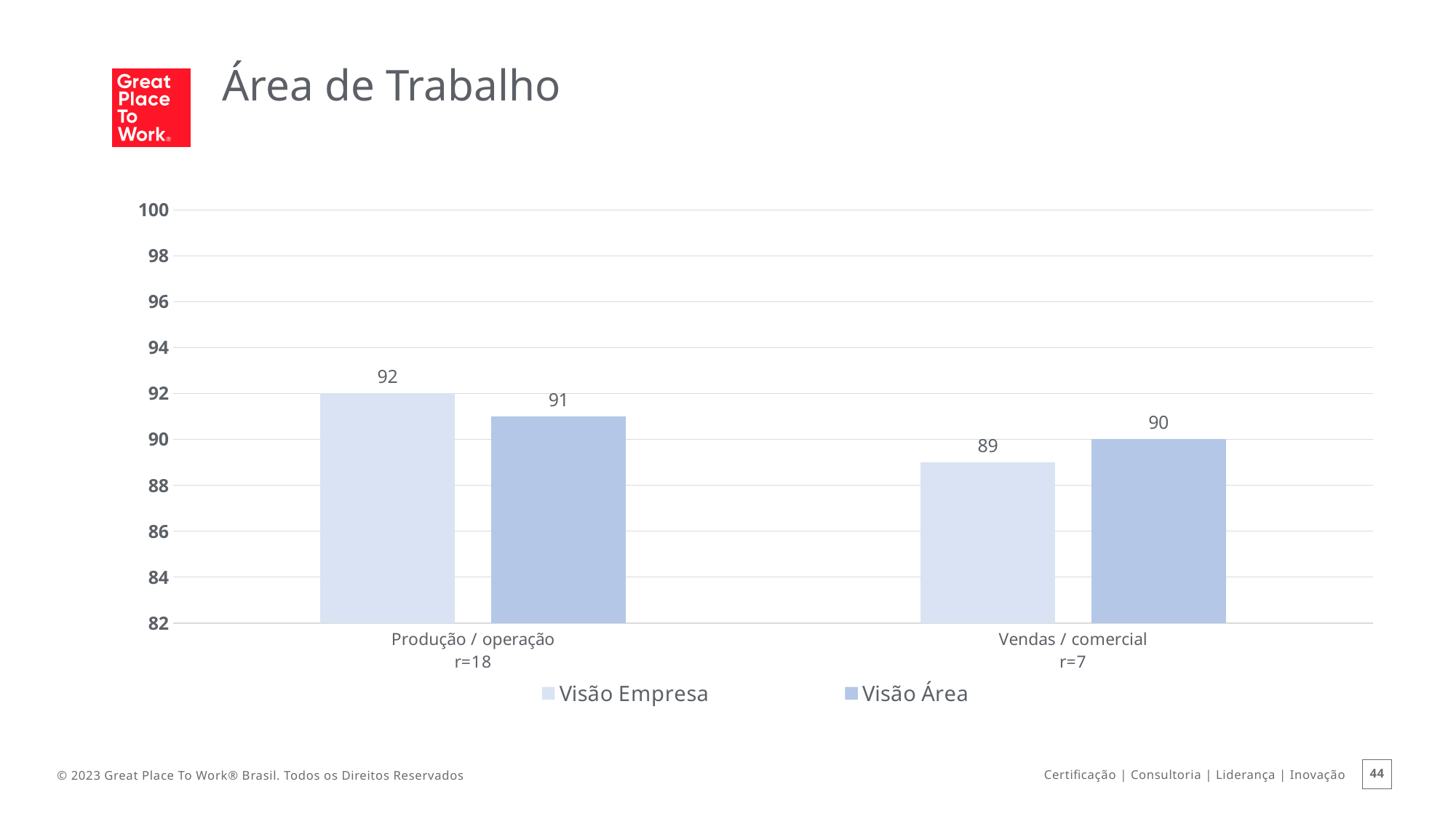
What is the Visão Área value for Produção / operação? 91 How many series does the legend list? 2 For Vendas / comercial, which is larger: Visão Empresa or Visão Área? Visão Área What is the Visão Área value for Vendas / comercial? 90 What is the Visão Empresa value for Produção / operação? 92 How many categories are shown on the x axis? 2 What kind of chart is shown on the slide? bar chart Which category has the lowest Visão Área value? Vendas / comercial What is the Visão Empresa value for Vendas / comercial? 89 Is the Visão Empresa value for Vendas / comercial greater or less than 90? less What is the difference between the Visão Empresa values for Produção / operação and Vendas / comercial? 3 Which category has the highest Visão Empresa value? Produção / operação